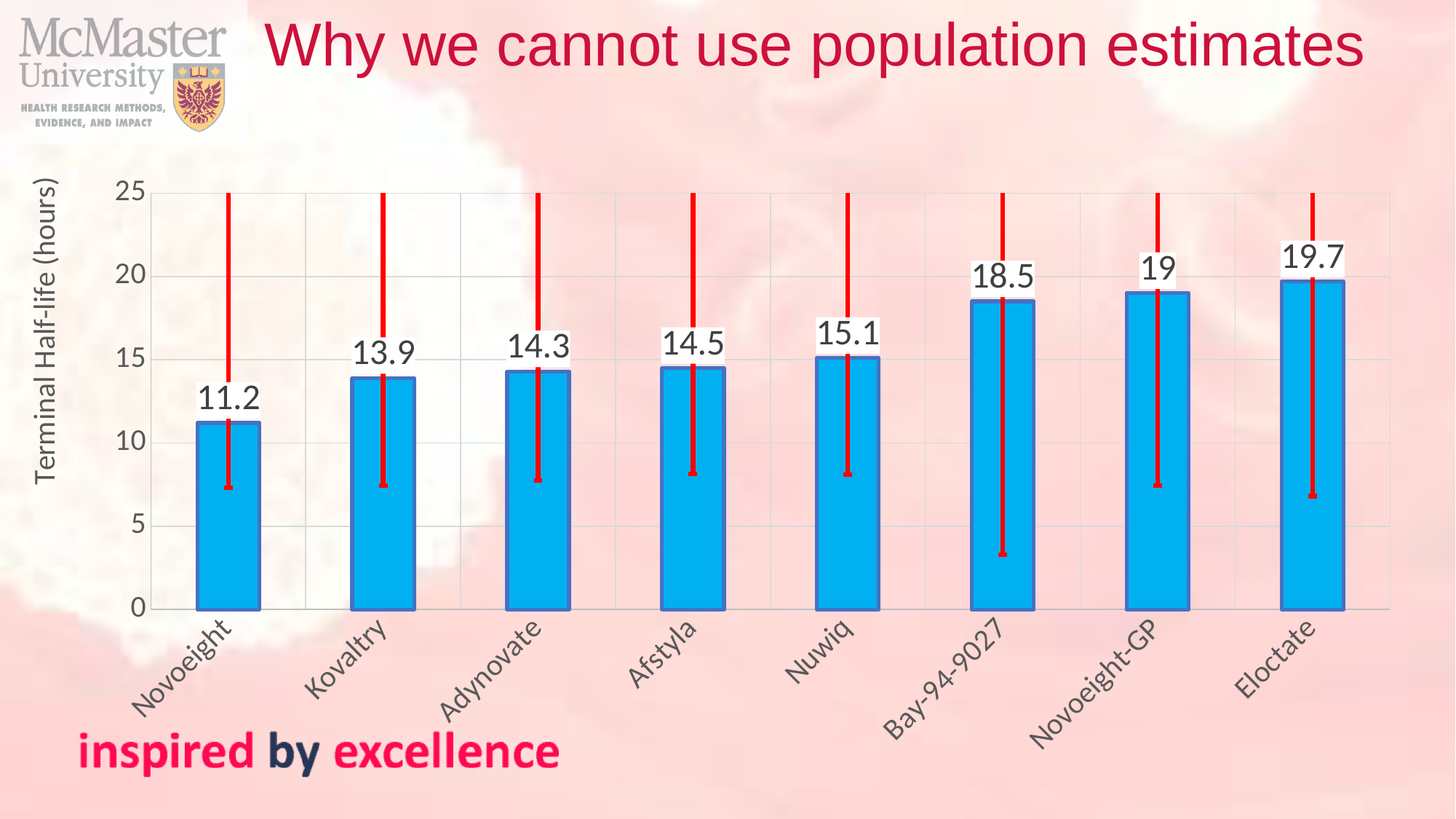
What is the difference between the terminal half-life of Novoeight-GP and Kovaltry? 5.1 What is the label of the vertical axis of the chart? Terminal Half-life (hours) Which product has the highest terminal half-life in the chart? Eloctate Which product has the lowest terminal half-life in the chart? Novoeight What kind of chart is shown on the slide? Bar chart What is the difference between the terminal half-life of Eloctate and Novoeight? 8.5 What is the terminal half-life value shown for Bay-94-9027? 18.5 How many products are shown on the x axis of the chart? 8 Is the terminal half-life for Nuwiq greater or less than 15? greater What is the terminal half-life value shown for Nuwiq? 15.1 Which has a larger terminal half-life, Adynovate or Afstyla? Afstyla What is the terminal half-life value shown for Novoeight? 11.2